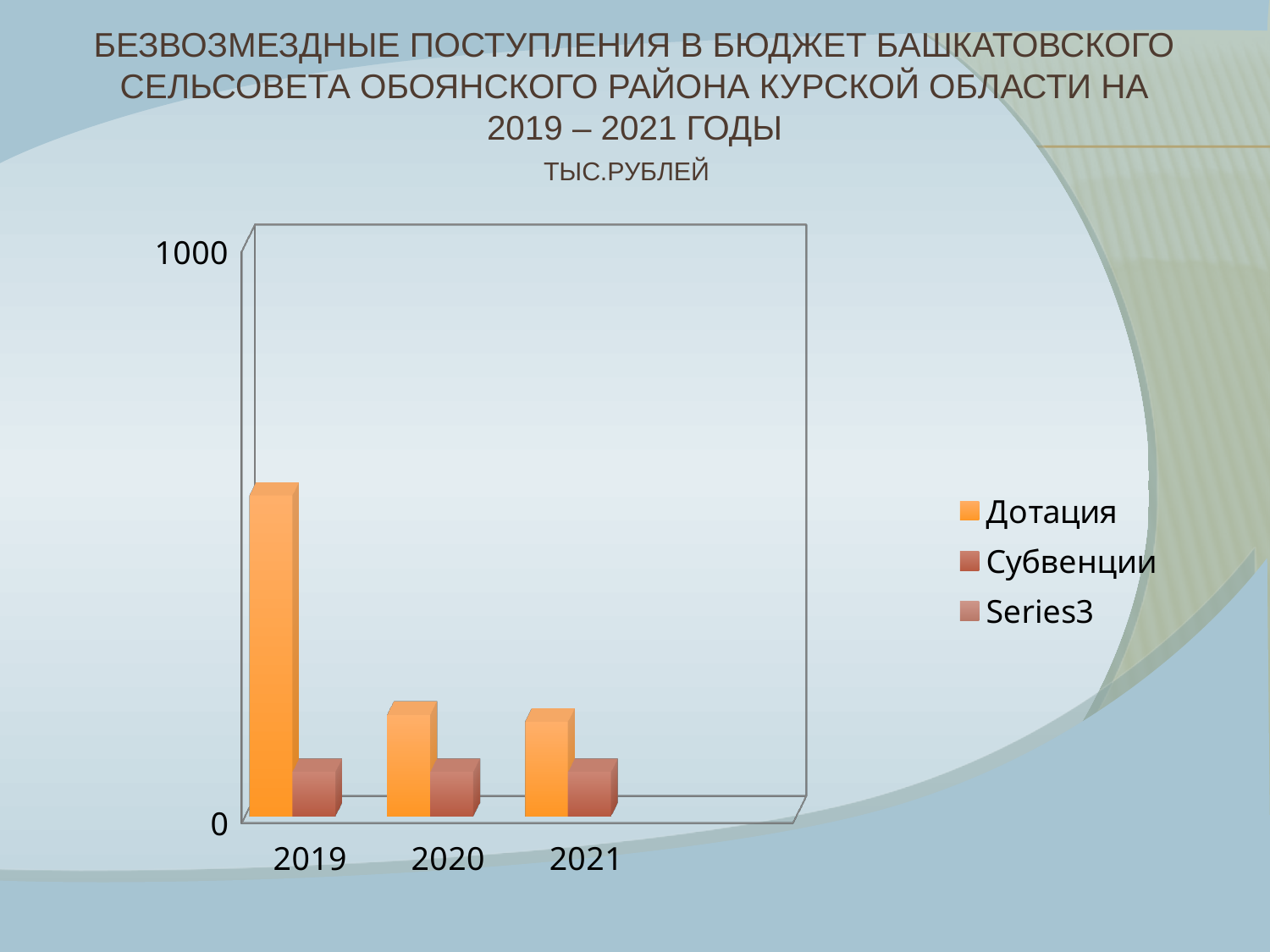
Which is larger in 2021, Дотация or Субвенции? Дотация How many series does the chart legend list? 3 Is the Дотация value for 2019 greater or less than 1000? less What unit is stated below the chart title? ТЫС.РУБЛЕЙ Does the Дотация value rise or fall from 2019 to 2020? fall How many years are shown on the x axis of the chart? 3 Which year has a larger Дотация value, 2019 or 2021? 2019 Which is larger in 2019, Дотация or Субвенции? Дотация What kind of chart is shown on the slide? bar chart In which year is the Дотация bar the highest? 2019 Which series is shown in orange in the legend? Дотация